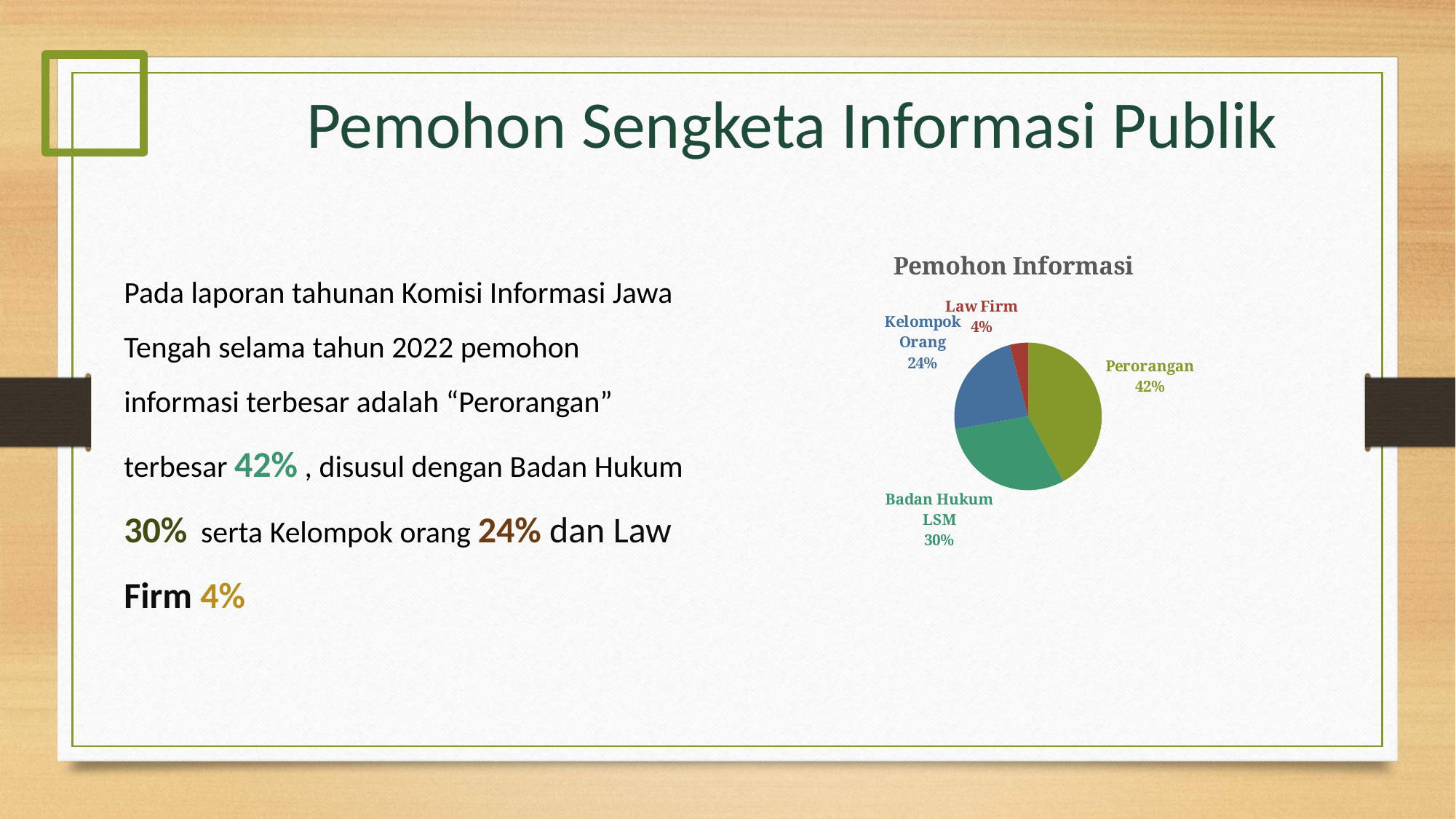
What share of the pie does Perorangan have? 42% What share of the pie does Law Firm have? 4% Which is larger, the share for Kelompok Orang or the share for Badan Hukum LSM? Badan Hukum LSM What is the difference between the shares of Kelompok Orang and Law Firm? 20% What kind of chart is shown on the slide? pie chart What is the difference between the shares of Perorangan and Badan Hukum LSM? 12% Which category has the largest slice of the pie? Perorangan What share of the pie does Badan Hukum LSM have? 30% What is the title of the chart? Pemohon Informasi Which category has the smallest slice of the pie? Law Firm How many categories are shown in the pie chart? 4